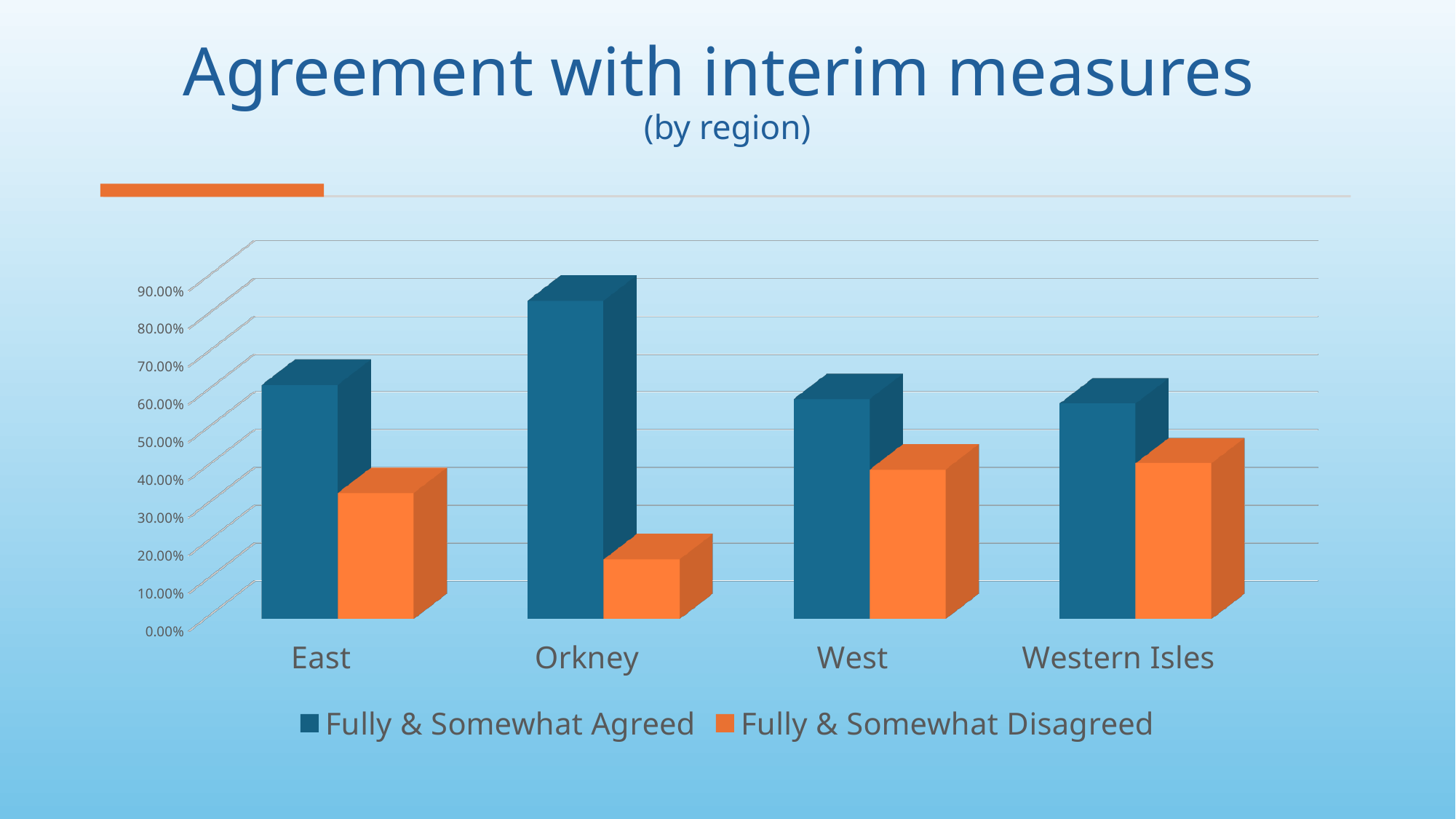
What is the title of the chart on the slide? Agreement with interim measures (by region) Which region has the highest value for Fully & Somewhat Disagreed? Western Isles How many regions are shown on the x axis of the chart? 4 Which region has the highest value for Fully & Somewhat Agreed? Orkney How many series does the chart legend list? 2 Is the Fully & Somewhat Agreed value for Orkney greater or less than 80.00%? greater For West, which is larger: Fully & Somewhat Agreed or Fully & Somewhat Disagreed? Fully & Somewhat Agreed Which region has the lowest value for Fully & Somewhat Disagreed? Orkney Is the Fully & Somewhat Disagreed value for Orkney greater or less than 20.00%? less What kind of chart is shown on the slide? bar chart Is the Fully & Somewhat Disagreed value for West greater or less than 50.00%? less